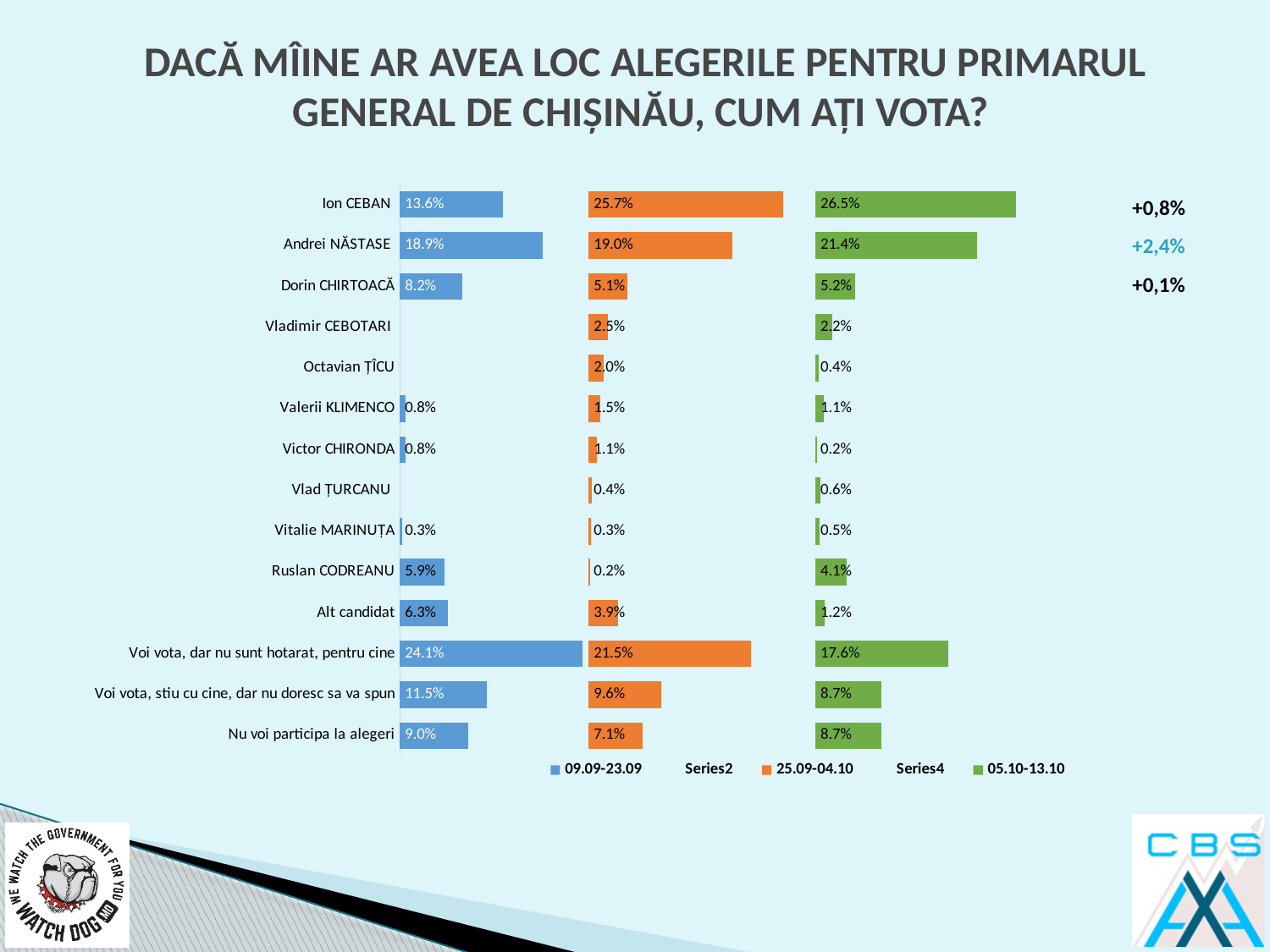
What is the value for Ruslan CODREANU in the 25.09-04.10 series? 0.2% What is the value for 'Nu voi participa la alegeri' in the 05.10-13.10 series? 8.7% Which is larger in the 05.10-13.10 series: Ruslan CODREANU or Alt candidat? Ruslan CODREANU Does Ion CEBAN's value rise or fall across the three survey periods from 09.09-23.09 to 05.10-13.10? rise What is the value for Ion CEBAN in the 05.10-13.10 series? 26.5% Which category has the lowest value in the 05.10-13.10 series? Victor CHIRONDA What kind of chart is shown on the slide? bar chart How many categories are listed on the vertical axis of the chart? 14 Which category has the highest value in the 25.09-04.10 series? Ion CEBAN What is the value for 'Voi vota, dar nu sunt hotarat, pentru cine' in the 09.09-23.09 series? 24.1% What is the value for Andrei NĂSTASE in the 09.09-23.09 series? 18.9% What is the difference between Ion CEBAN's values in the 05.10-13.10 and 25.09-04.10 series? 0.8%